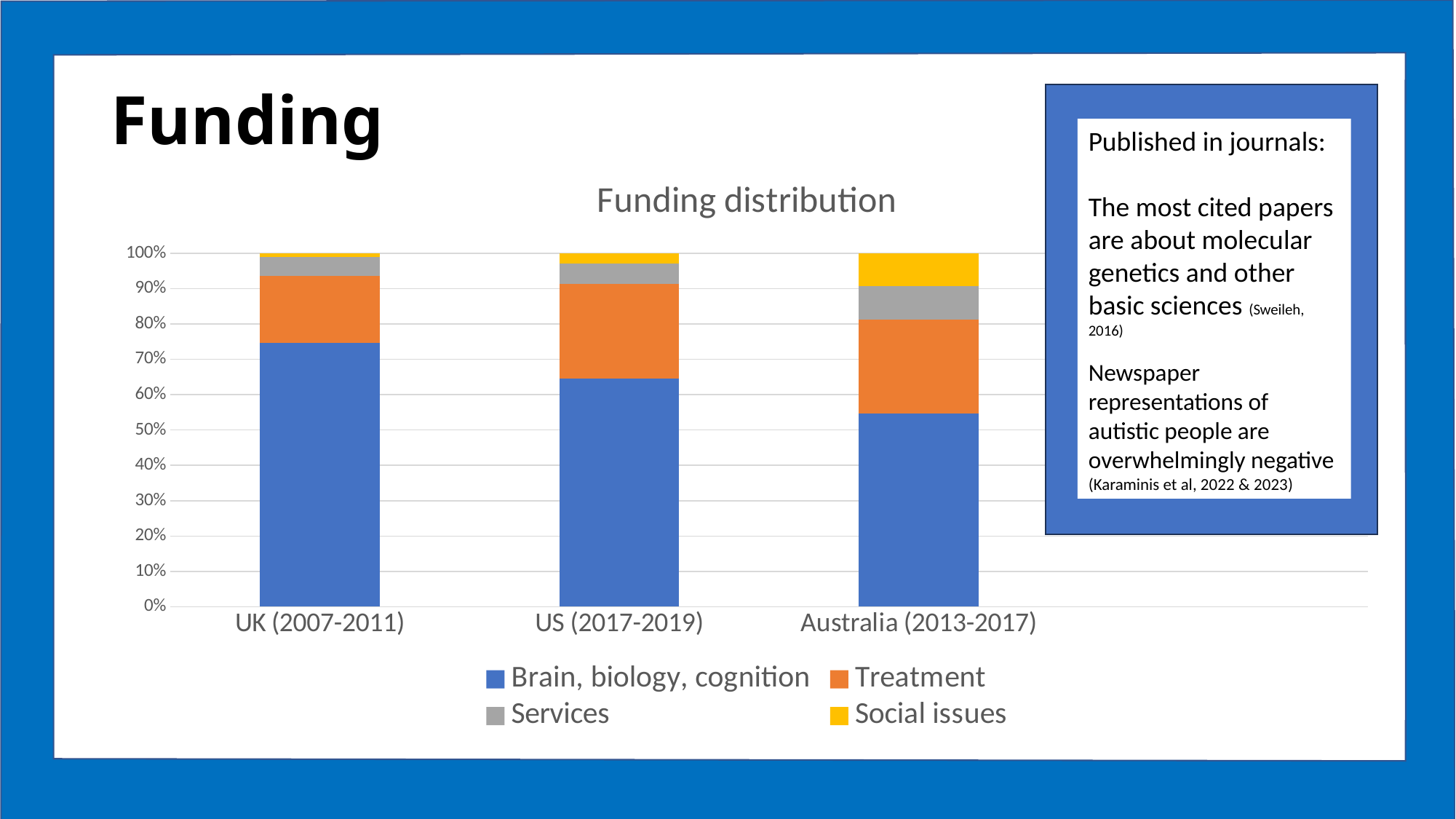
How many categories are shown on the x axis of the chart? 3 What colour represents Social issues in the chart? yellow Which category has the smallest share for Brain, biology, cognition? Australia (2013-2017) Which category has the largest share for Brain, biology, cognition? UK (2007-2011) How many series does the chart legend list? 4 Is the Brain, biology, cognition share for Australia (2013-2017) greater or less than 60%? less Which category has the largest share for Social issues? Australia (2013-2017) What type of chart is shown on the slide? bar chart Is the Brain, biology, cognition share for UK (2007-2011) greater or less than 70%? greater Which has the larger Treatment share, UK (2007-2011) or US (2017-2019)? US (2017-2019) Is the Brain, biology, cognition share for US (2017-2019) greater or less than 70%? less What is the title of the chart? Funding distribution